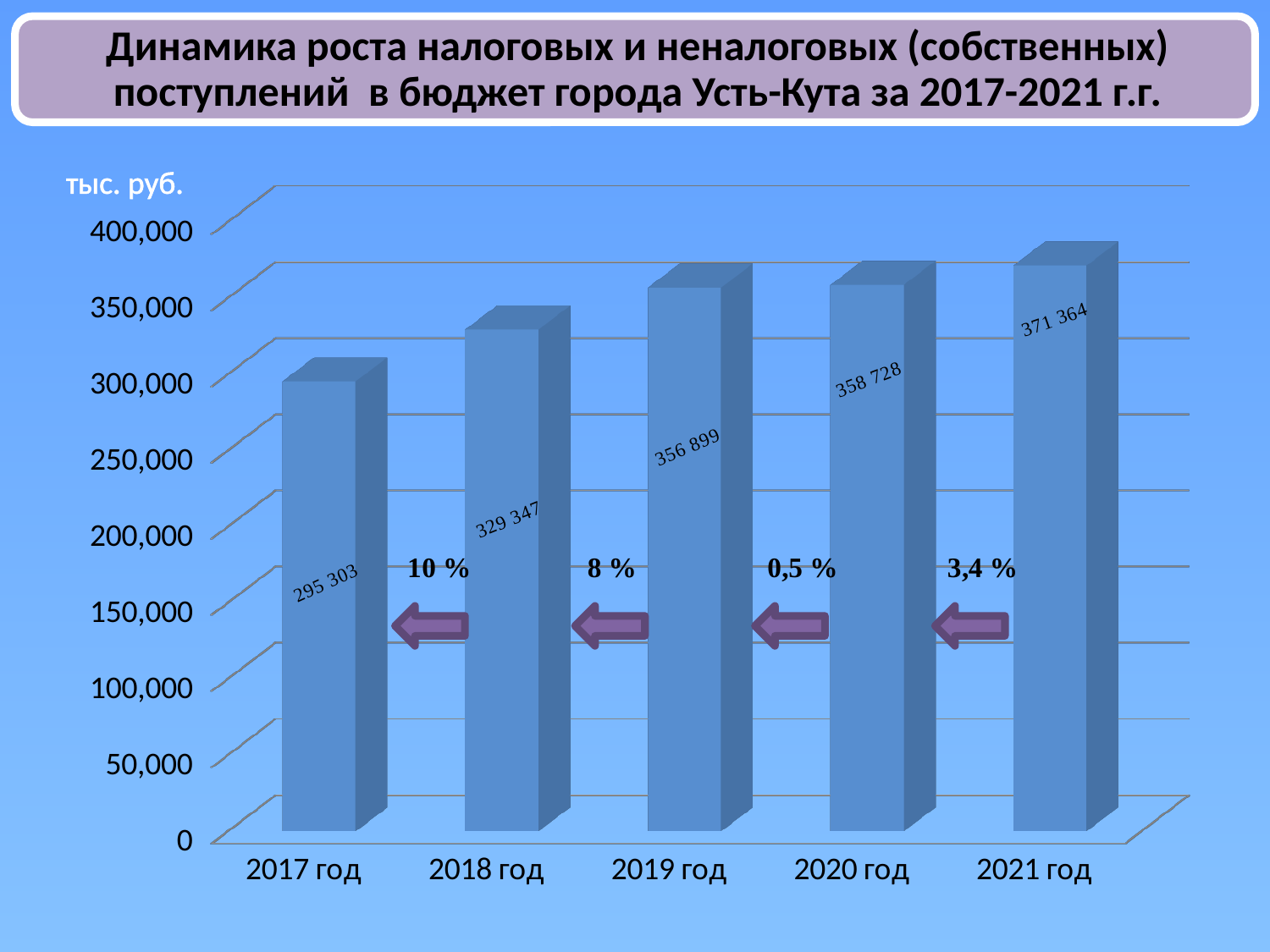
Do the values rise or fall from 2017 год to 2021 год? rise Which is larger, the value for 2018 год or 2019 год? 2019 год What kind of chart is shown on the slide? bar chart Which year has the lowest value? 2017 год What is the value for 2017 год? 295 303 Is the value for 2021 год greater or less than 350,000? greater What is the difference between the values for 2018 год and 2017 год? 34 044 What is the value for 2021 год? 371 364 What is the difference between the values for 2021 год and 2017 год? 76 061 How many years are shown on the x axis? 5 What is the value for 2020 год? 358 728 Which year has the highest value? 2021 год